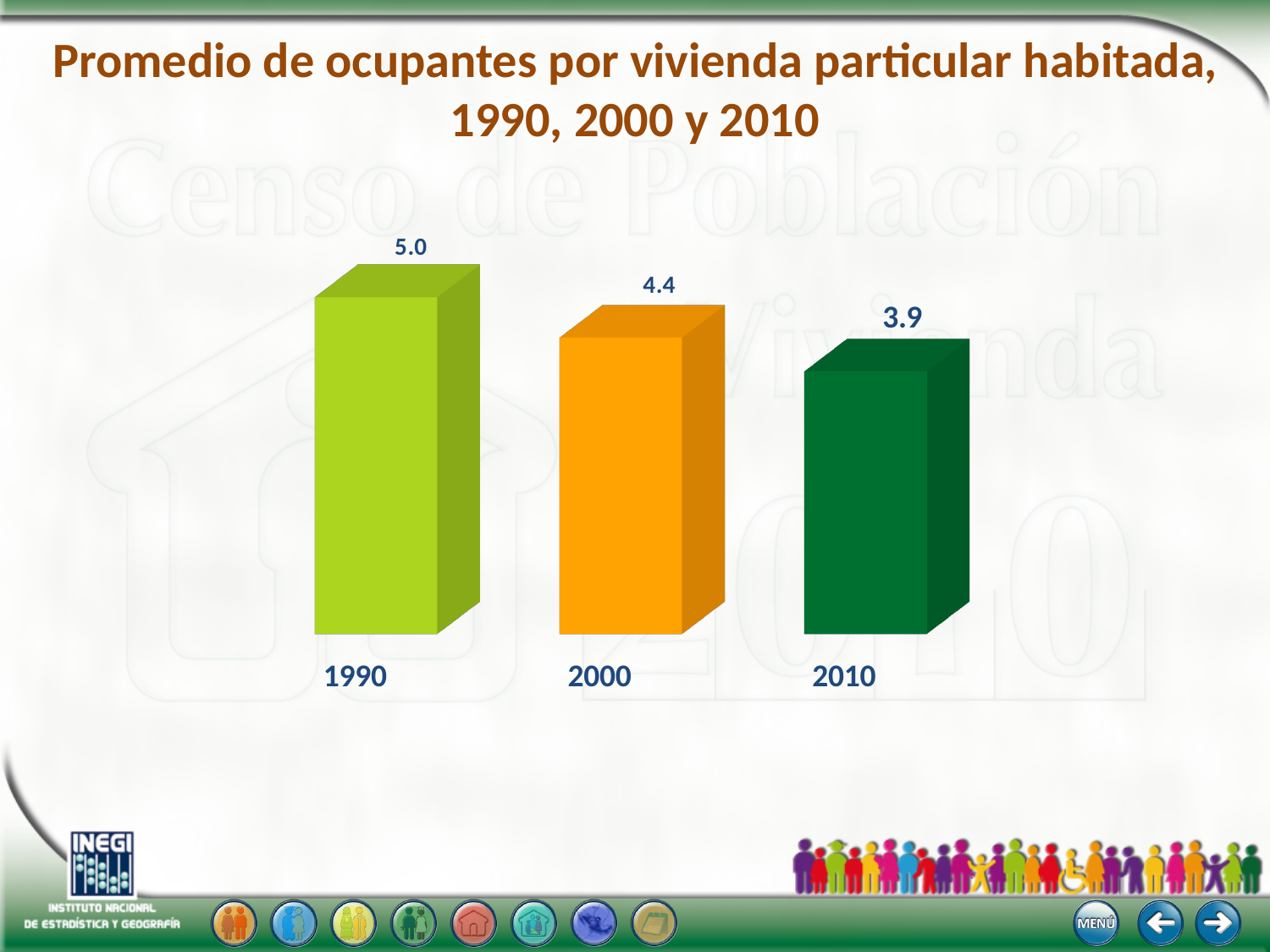
What colour is the bar for 2000? Orange What is the difference between the values for 2000 and 2010? 0.5 How many years are shown in the chart? 3 What kind of chart is shown on the slide? Bar chart What is the difference between the values for 1990 and 2010? 1.1 Which is larger, the value for 1990 or the value for 2000? 1990 What is the value shown for 2000? 4.4 Which year has the lowest average number of occupants per dwelling? 2010 What is the average number of occupants per inhabited private dwelling in 1990? 5.0 Do the values rise or fall from 1990 to 2010? Fall What is the value shown for 2010? 3.9 Which year has the highest average number of occupants per dwelling? 1990